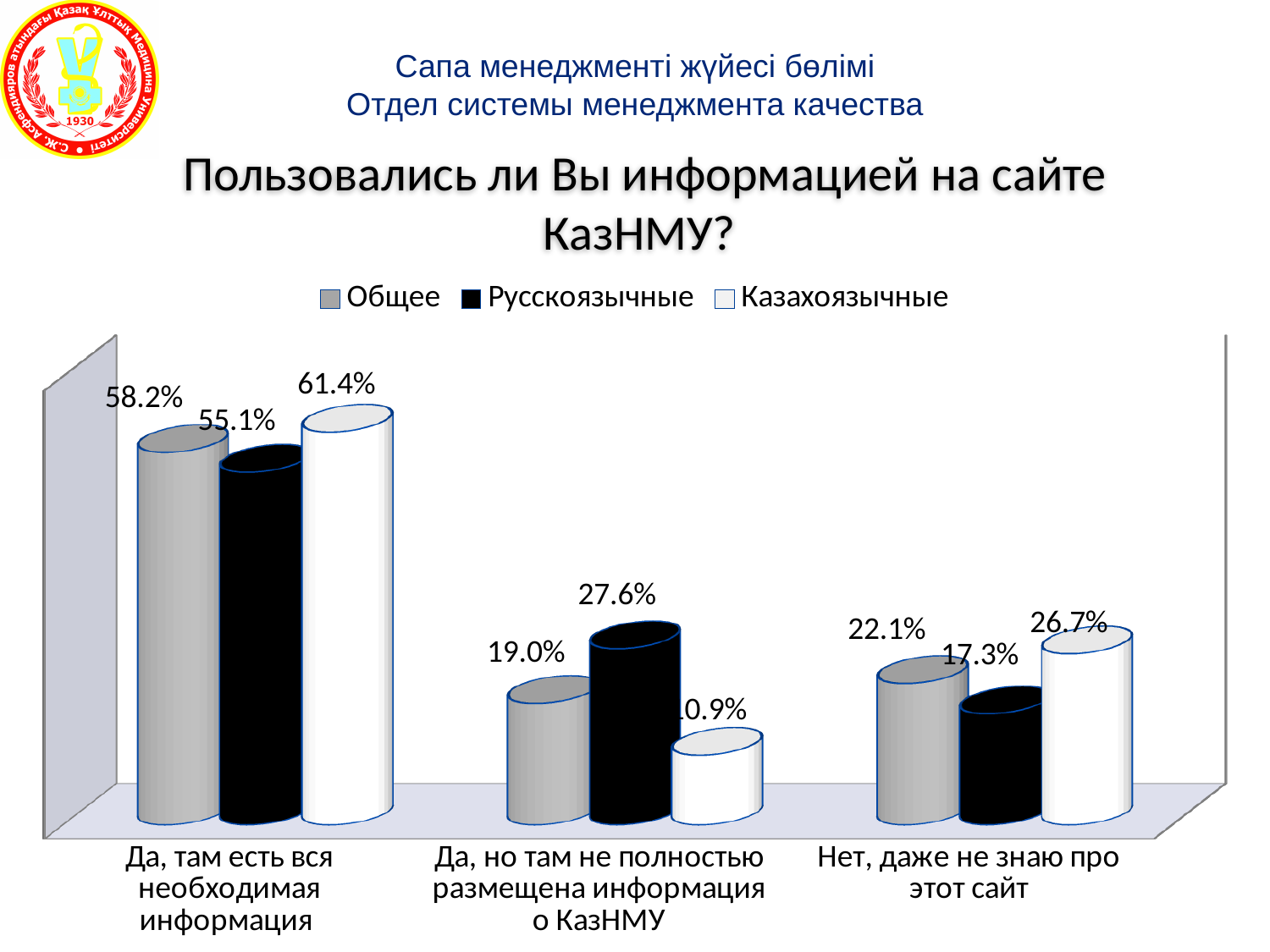
How many series does the legend list? 3 What is the difference between the Казахоязычные and Общее values in the category 'Да, там есть вся необходимая информация'? 3.2% How many categories are shown on the x axis? 3 What kind of chart is shown on the slide? Bar chart What is the difference between the Русскоязычные and Общее values in the category 'Да, но там не полностью размещена информация о КазНМУ'? 8.6% Which series has the highest value in the category 'Да, там есть вся необходимая информация'? Казахоязычные What is the value for Русскоязычные in the category 'Да, но там не полностью размещена информация о КазНМУ'? 27.6% What is the value for Русскоязычные in the category 'Нет, даже не знаю про этот сайт'? 17.3% Which series has the lowest value in the category 'Нет, даже не знаю про этот сайт'? Русскоязычные What is the value for Казахоязычные in the category 'Нет, даже не знаю про этот сайт'? 26.7% What is the value for Общее in the category 'Да, там есть вся необходимая информация'? 58.2% Which is larger in the category 'Нет, даже не знаю про этот сайт': the Общее value or the Казахоязычные value? Казахоязычные